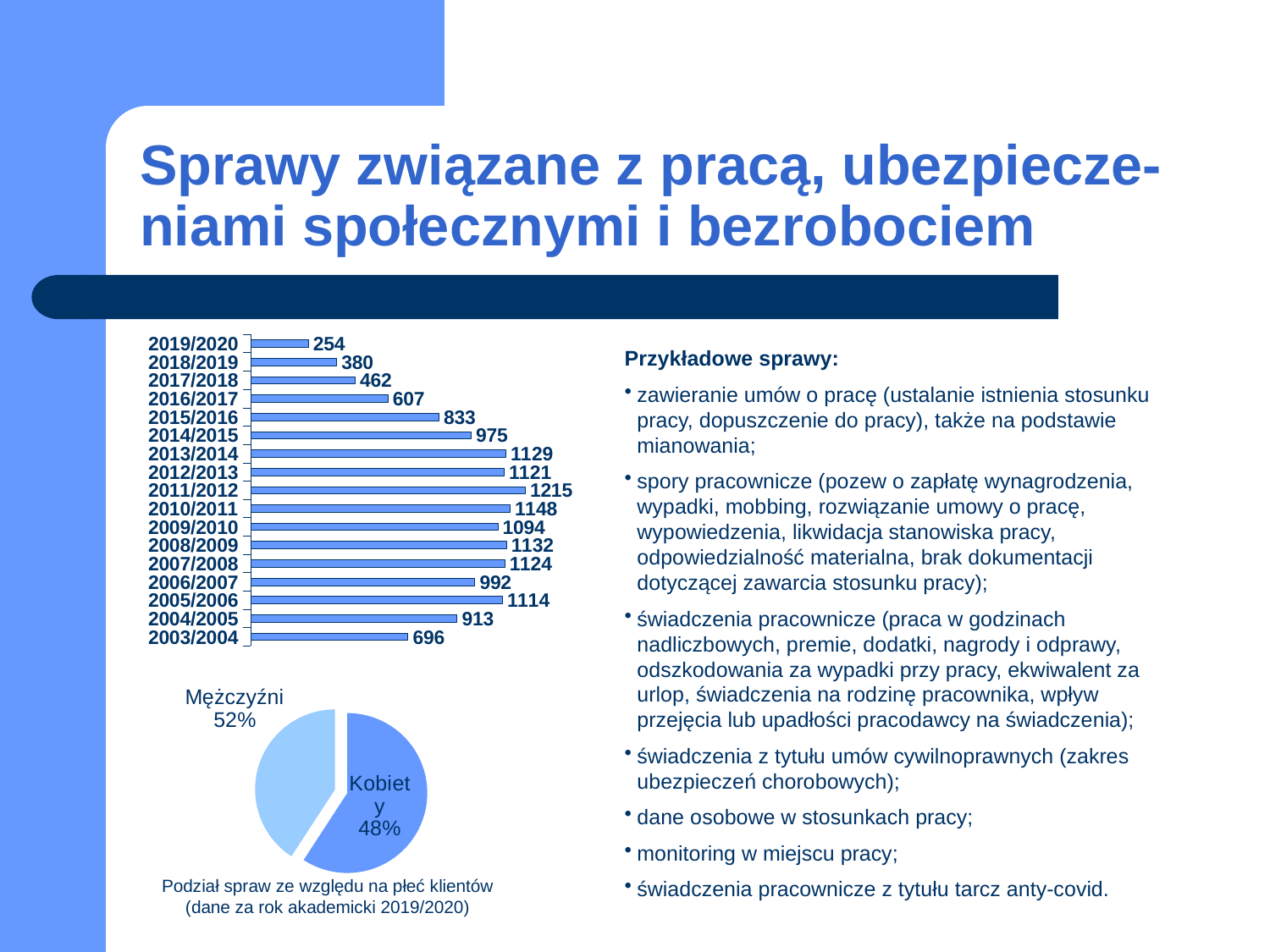
What kind of chart is the chart at the top left of the slide? bar chart In the bar chart on the left, what is the difference between the values for 2018/2019 and 2019/2020? 126 In the bar chart on the left, do the values rise or fall from 2015/2016 to 2019/2020? fall In the bar chart on the left, which year has the lowest value? 2019/2020 In the bar chart on the left, what is the value for 2011/2012? 1215 In the bar chart on the left, which is larger, the value for 2015/2016 or the value for 2014/2015? 2014/2015 How many years are shown in the bar chart on the left? 17 In the bar chart on the left, which year has the highest value? 2011/2012 In the pie chart at the bottom left, what share is labelled Kobiety? 48% In the bar chart on the left, what is the value for 2019/2020? 254 In the bar chart on the left, what is the value for 2003/2004? 696 In the pie chart at the bottom left, what share is labelled Mężczyźni? 52%